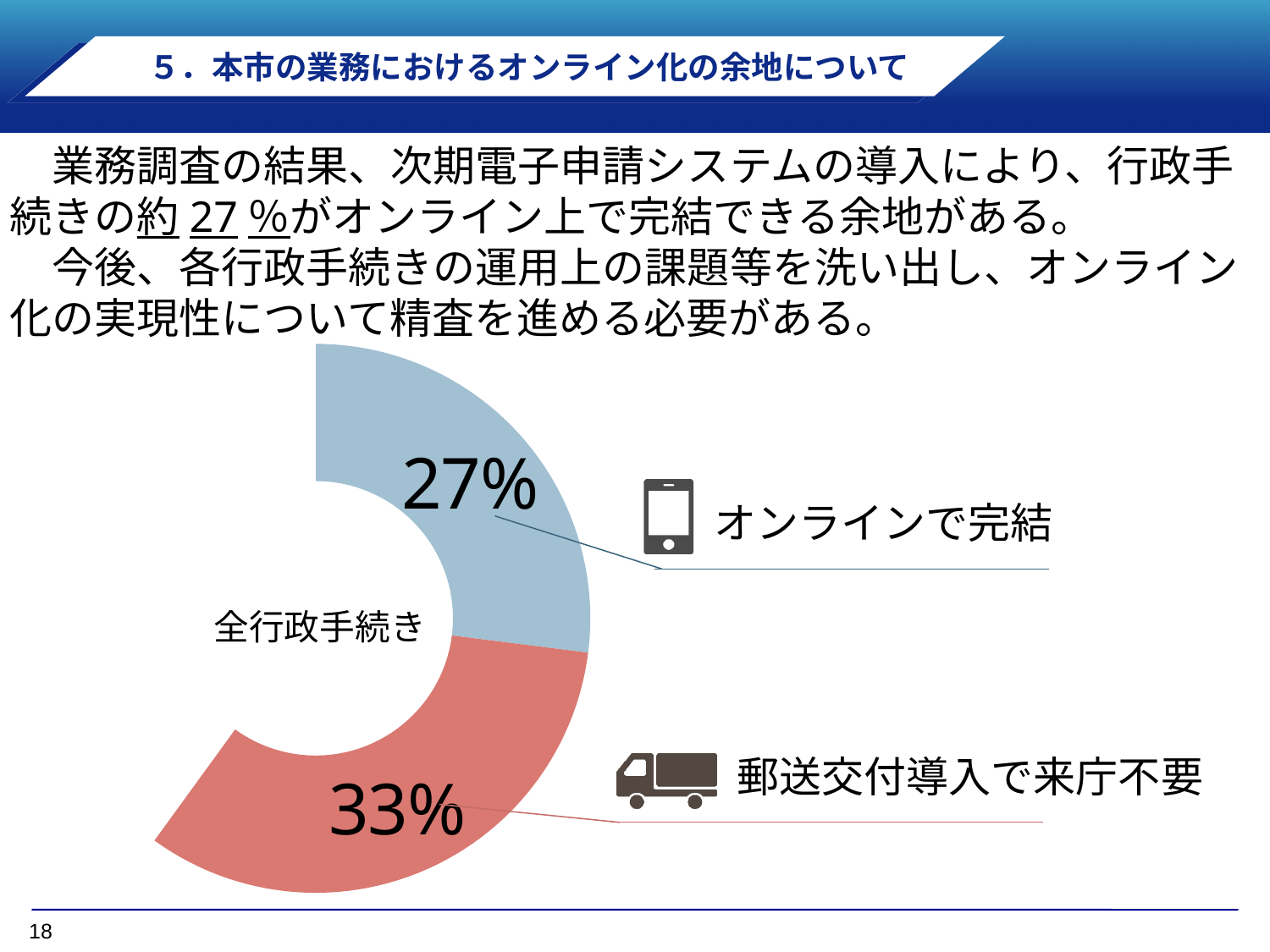
Which labeled segment of the chart has the larger share, オンラインで完結 or 郵送交付導入で来庁不要? 郵送交付導入で来庁不要 Which labeled segment of the chart has the smaller share? オンラインで完結 How many labeled segments does the chart show? 2 What label appears in the centre of the donut chart? 全行政手続き Is the value for 郵送交付導入で来庁不要 larger or smaller than the value for オンラインで完結? larger What kind of chart is shown on the slide? Donut (pie) chart What colour is the segment labeled オンラインで完結? Light blue What percentage of all administrative procedures is shown for オンラインで完結 (completed online)? 27% What percentage is shown for 郵送交付導入で来庁不要 (no visit needed with postal delivery)? 33% What is the difference in percentage points between the 郵送交付導入で来庁不要 segment and the オンラインで完結 segment? 6 percentage points